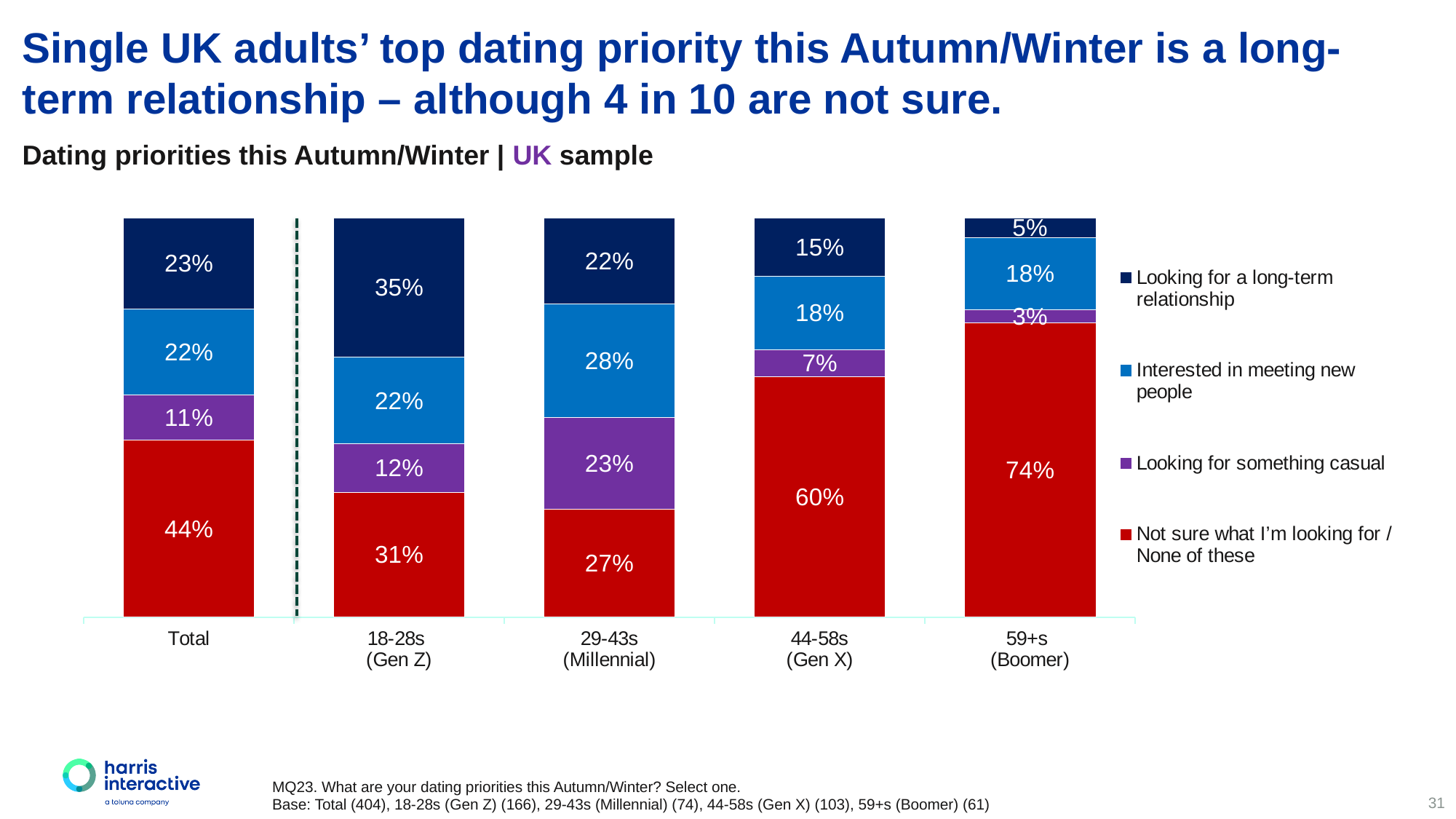
Which age group has the lowest share looking for a long-term relationship? 59+s (Boomer) Which is larger for 29-43s (Millennial): the share interested in meeting new people or the share looking for a long-term relationship? Interested in meeting new people What percentage of 59+s (Boomer) are interested in meeting new people? 18% What is the difference between the 'Not sure' share for 44-58s (Gen X) and for 18-28s (Gen Z)? 29 percentage points What percentage of 18-28s (Gen Z) are looking for a long-term relationship? 35% What kind of chart is shown on the slide? Stacked bar chart What percentage of the Total sample is 'Not sure what I'm looking for / None of these'? 44% What percentage of 29-43s (Millennial) are looking for something casual? 23% How many series does the legend list? 4 How many age-group categories (including Total) are shown on the x axis? 5 Which age group has the highest share of 'Not sure what I'm looking for / None of these'? 59+s (Boomer) What is the total of the stacked bar for 44-58s (Gen X)? 100%